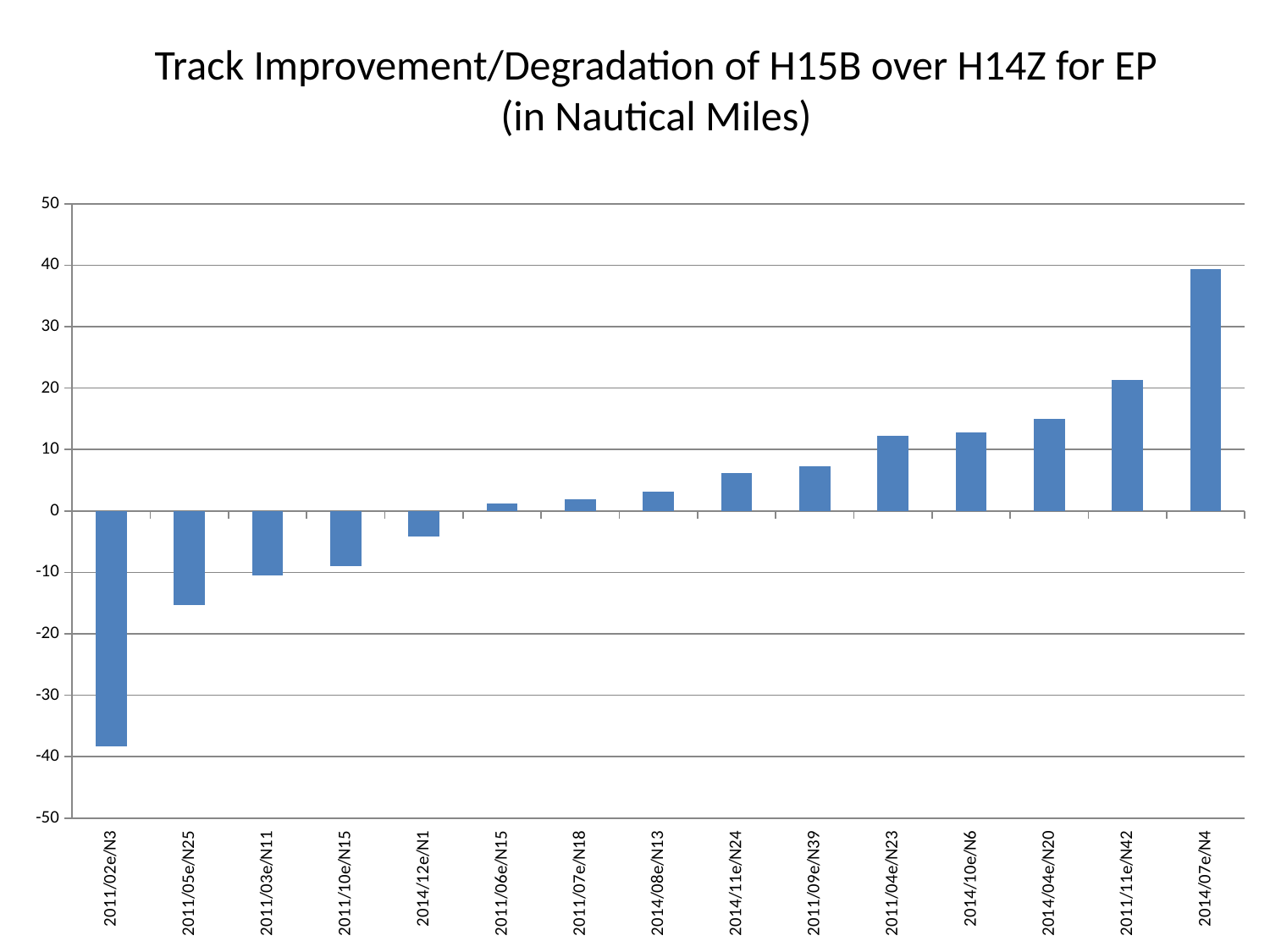
Is the value for 2014/04e/N20 greater or less than 10? greater Is the value for 2011/05e/N25 greater or less than -10? less Which category has the lowest value? 2011/02e/N3 Is the value for 2014/12e/N1 greater or less than -10? greater What unit does the chart title say the values are in? Nautical Miles How many categories are plotted along the x axis? 15 Which has the larger value, 2011/11e/N42 or 2014/04e/N20? 2011/11e/N42 Which category has the highest value? 2014/07e/N4 What kind of chart is shown on the slide? Bar chart Do the values rise or fall moving from left to right along the x axis? Rise